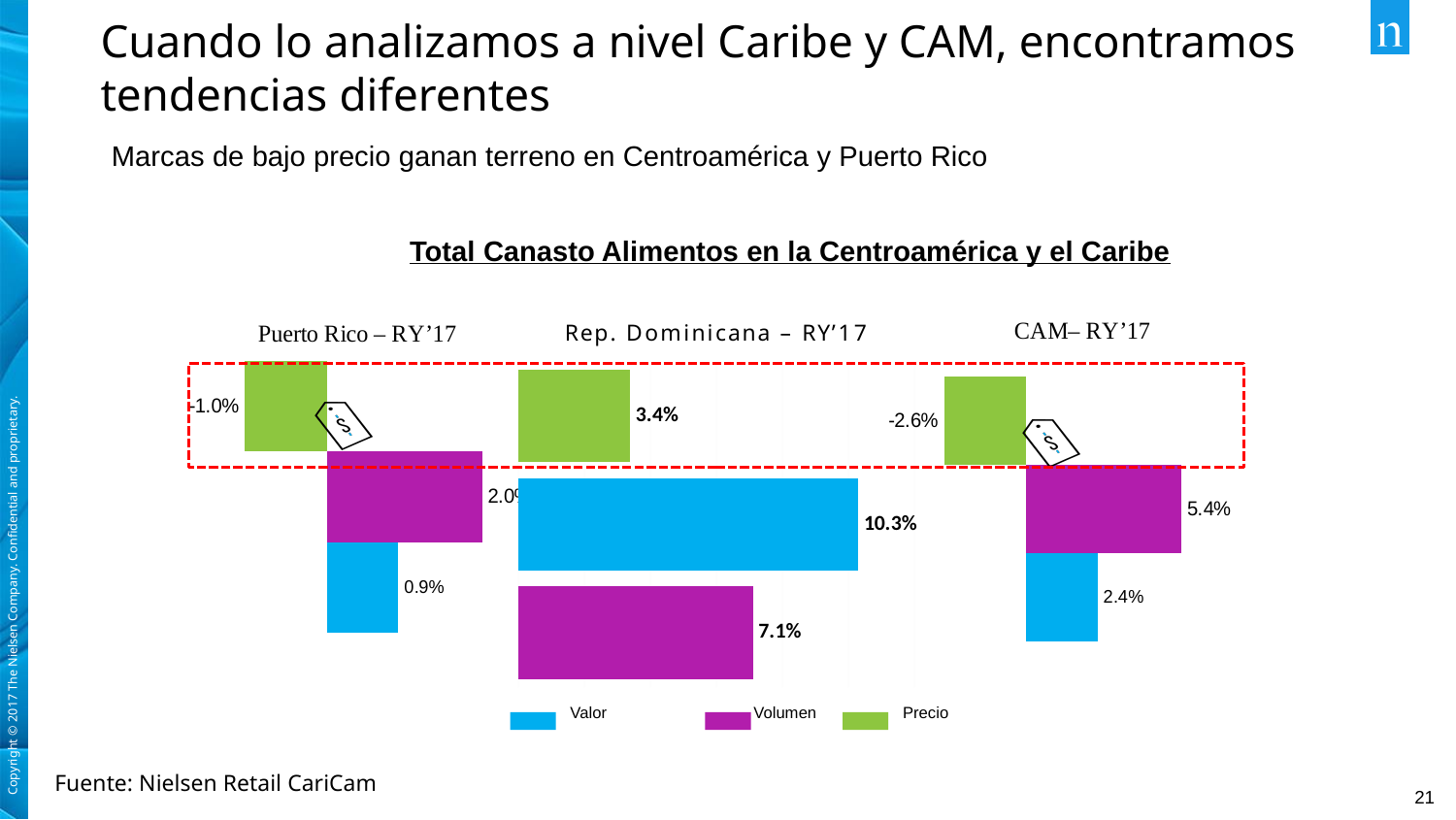
In the Puerto Rico – RY'17 chart, what is the value for Valor? 0.9% In the Rep. Dominicana – RY'17 chart, which measure has the highest value? Valor In the CAM – RY'17 chart, what is the value for Volumen? 5.4% In the CAM – RY'17 chart, which is larger, Volumen or Valor? Volumen In the Rep. Dominicana – RY'17 chart, what is the value for Valor? 10.3% In the Rep. Dominicana – RY'17 chart, what is the value for Volumen? 7.1% In the CAM – RY'17 chart, which measure has the lowest value? Precio In the Rep. Dominicana – RY'17 chart, what is the difference between Valor and Volumen? 3.2% In the Puerto Rico – RY'17 chart, what is the value for Precio? -1.0% In the Rep. Dominicana – RY'17 chart, what is the value for Precio? 3.4% How many entries does the legend list? 3 In the CAM – RY'17 chart, what is the value for Precio? -2.6%